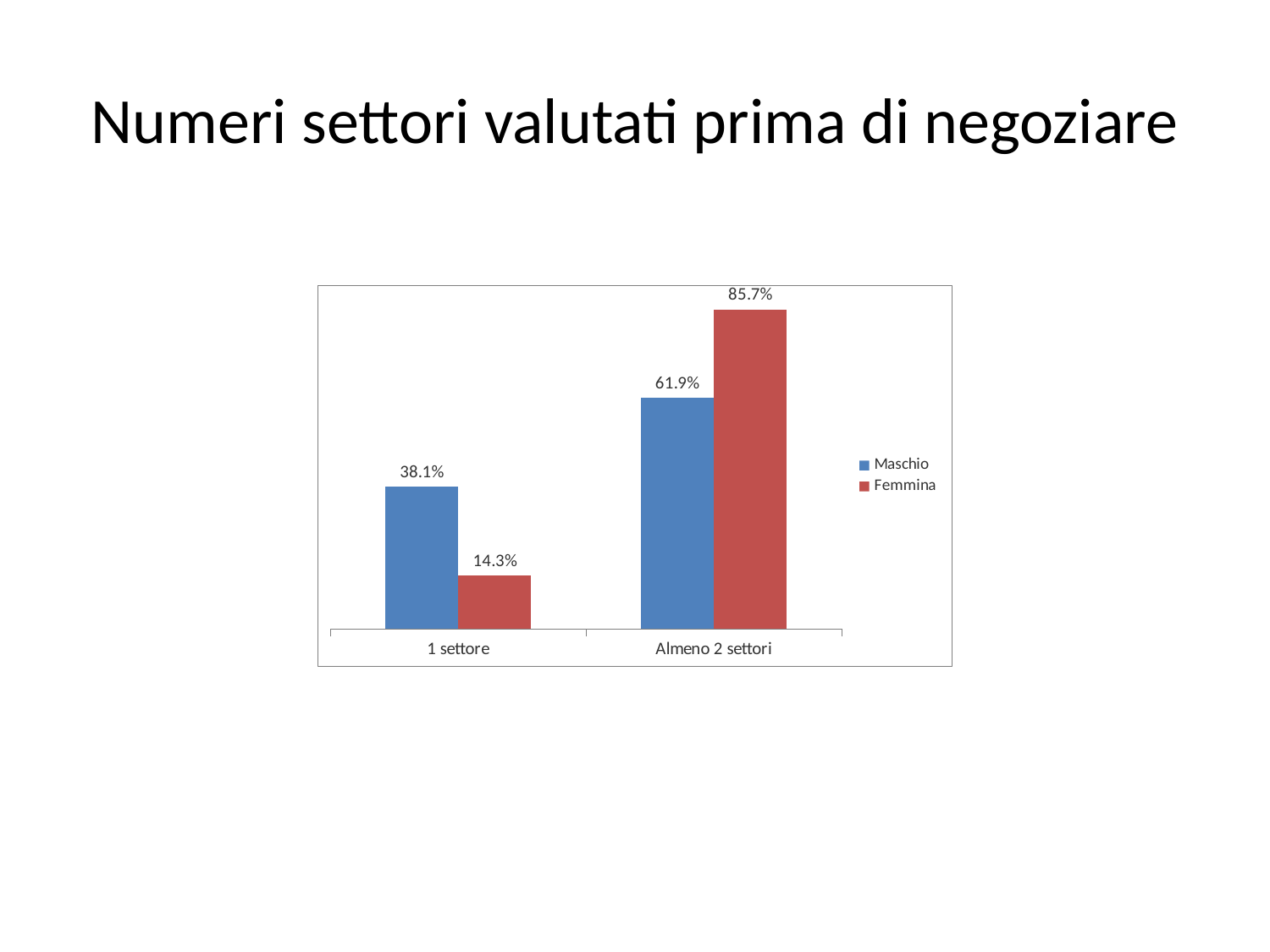
How many categories are shown on the x axis? 2 What is the difference between the Femmina and Maschio values in the 'Almeno 2 settori' category? 23.8% What is the difference between the Maschio and Femmina values in the '1 settore' category? 23.8% What kind of chart is shown on the slide? Bar chart Which bar has the lowest value on the chart? Femmina, 1 settore How many series does the legend list? 2 What is the value for Maschio in the 'Almeno 2 settori' category? 61.9% What is the value for Femmina in the '1 settore' category? 14.3% Which bar has the highest value on the chart? Femmina, Almeno 2 settori What is the value for Maschio in the '1 settore' category? 38.1% In the '1 settore' category, which series has the larger value, Maschio or Femmina? Maschio What is the value for Femmina in the 'Almeno 2 settori' category? 85.7%